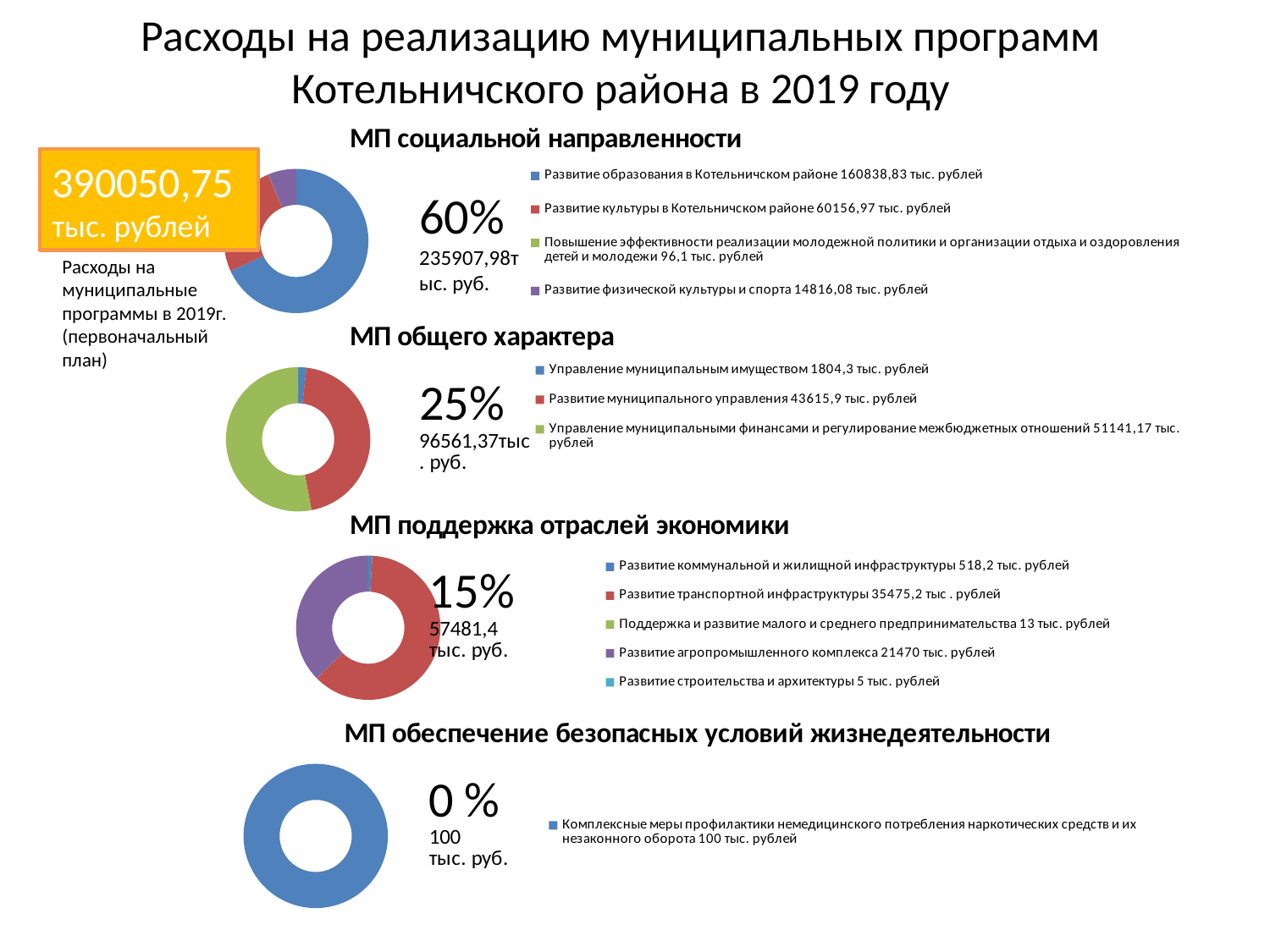
In the chart 'МП социальной направленности', which category has the smallest value? Повышение эффективности реализации молодежной политики и организации отдыха и оздоровления детей и молодежи In the chart 'МП общего характера', which category has the largest value? Управление муниципальными финансами и регулирование межбюджетных отношений What percentage is shown next to the chart 'МП общего характера'? 25% In the chart 'МП общего характера', what is the difference between 'Управление муниципальными финансами и регулирование межбюджетных отношений' and 'Развитие муниципального управления'? 7525,27 тыс. рублей In the chart 'МП поддержка отраслей экономики', what is the value for 'Развитие агропромышленного комплекса'? 21470 тыс. рублей What kind of chart is used for 'МП обеспечение безопасных условий жизнедеятельности'? Donut (pie) chart In the chart 'МП общего характера', what is the value for 'Развитие муниципального управления'? 43615,9 тыс. рублей In the chart 'МП поддержка отраслей экономики', which is larger: 'Развитие транспортной инфраструктуры' or 'Развитие агропромышленного комплекса'? Развитие транспортной инфраструктуры In the chart 'МП социальной направленности', what is the difference between 'Развитие образования в Котельничском районе' and 'Развитие культуры в Котельничском районе'? 100681,86 тыс. рублей In the chart 'МП социальной направленности', what is the value for 'Развитие образования в Котельничском районе'? 160838,83 тыс. рублей How many categories does the legend of the chart 'МП социальной направленности' list? 4 How many categories does the legend of the chart 'МП поддержка отраслей экономики' list? 5